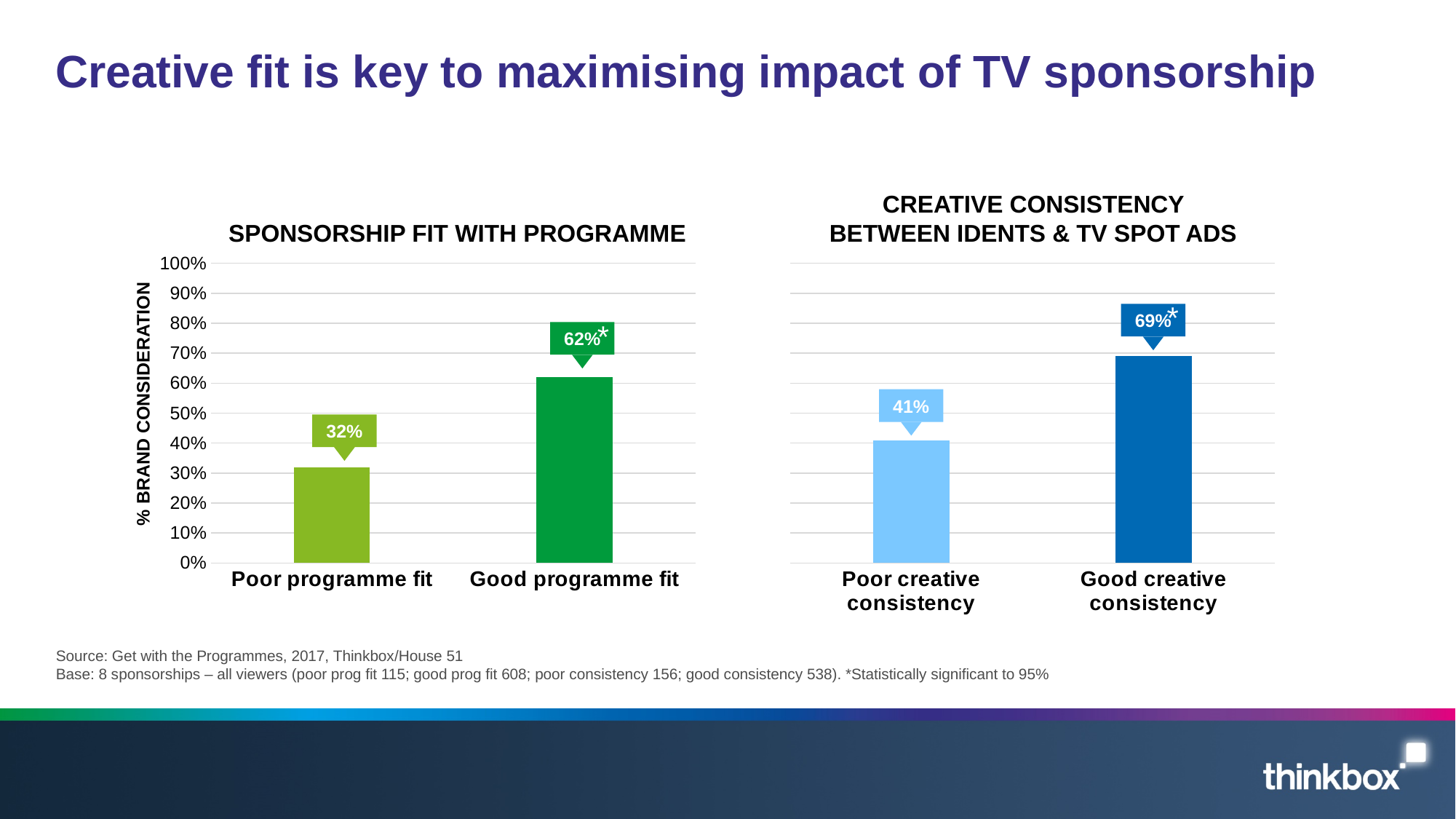
In the 'Sponsorship fit with programme' chart, what is the difference between Good programme fit and Poor programme fit? 30% Which is larger: the value for Good programme fit in the left chart or the value for Good creative consistency in the right chart? Good creative consistency In the 'Sponsorship fit with programme' chart, how many categories are shown? 2 In the 'Creative consistency between idents & TV spot ads' chart, what is the value for Good creative consistency? 69% In the 'Sponsorship fit with programme' chart, what is the value for Poor programme fit? 32% What kind of chart is the 'Creative consistency between idents & TV spot ads' chart? Bar chart In the 'Creative consistency between idents & TV spot ads' chart, what is the difference between Good creative consistency and Poor creative consistency? 28% In the 'Creative consistency between idents & TV spot ads' chart, which category has the lowest value? Poor creative consistency In the 'Sponsorship fit with programme' chart, which category has the highest value? Good programme fit What is the y-axis label of the 'Sponsorship fit with programme' chart? % BRAND CONSIDERATION In the 'Creative consistency between idents & TV spot ads' chart, what is the value for Poor creative consistency? 41% In the 'Sponsorship fit with programme' chart, what is the value for Good programme fit? 62%